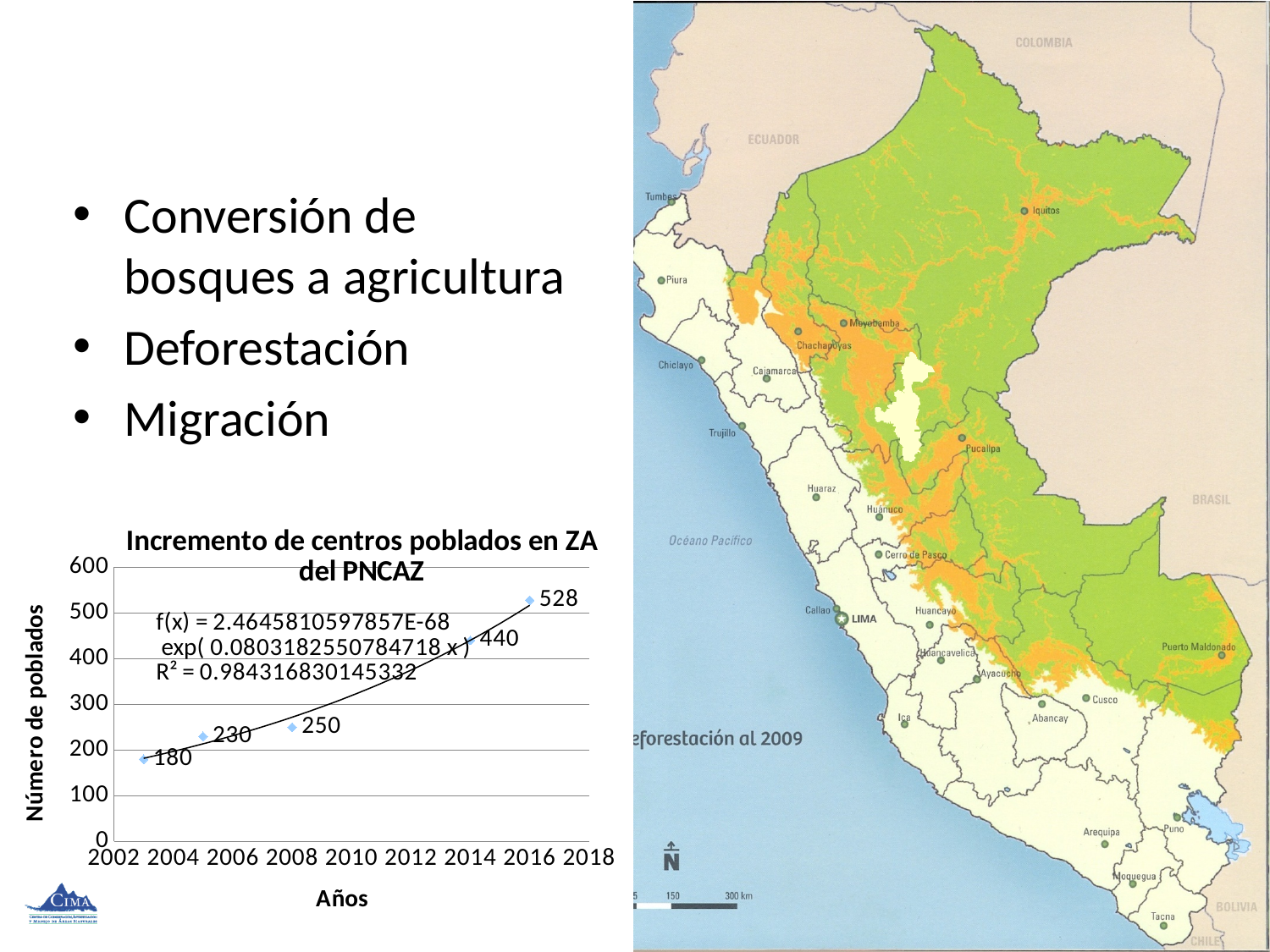
What is the value of the first (leftmost) data point in the chart? 180 What is the lowest value labelled in the chart? 180 What is the label of the vertical axis of the chart? Número de poblados What is the value of the last (rightmost) data point in the chart? 528 What kind of chart is shown on the slide? scatter chart Do the values rise or fall as the years increase along the x axis? rise How many data points are plotted in the chart? 5 What is the difference between the highest and lowest labelled values in the chart? 348 What is the highest value labelled in the chart? 528 What is the title of the chart? Incremento de centros poblados en ZA del PNCAZ Is the value of the second data point (labelled 230) greater or less than 200? greater What is the difference between the data points labelled 440 and 250? 190